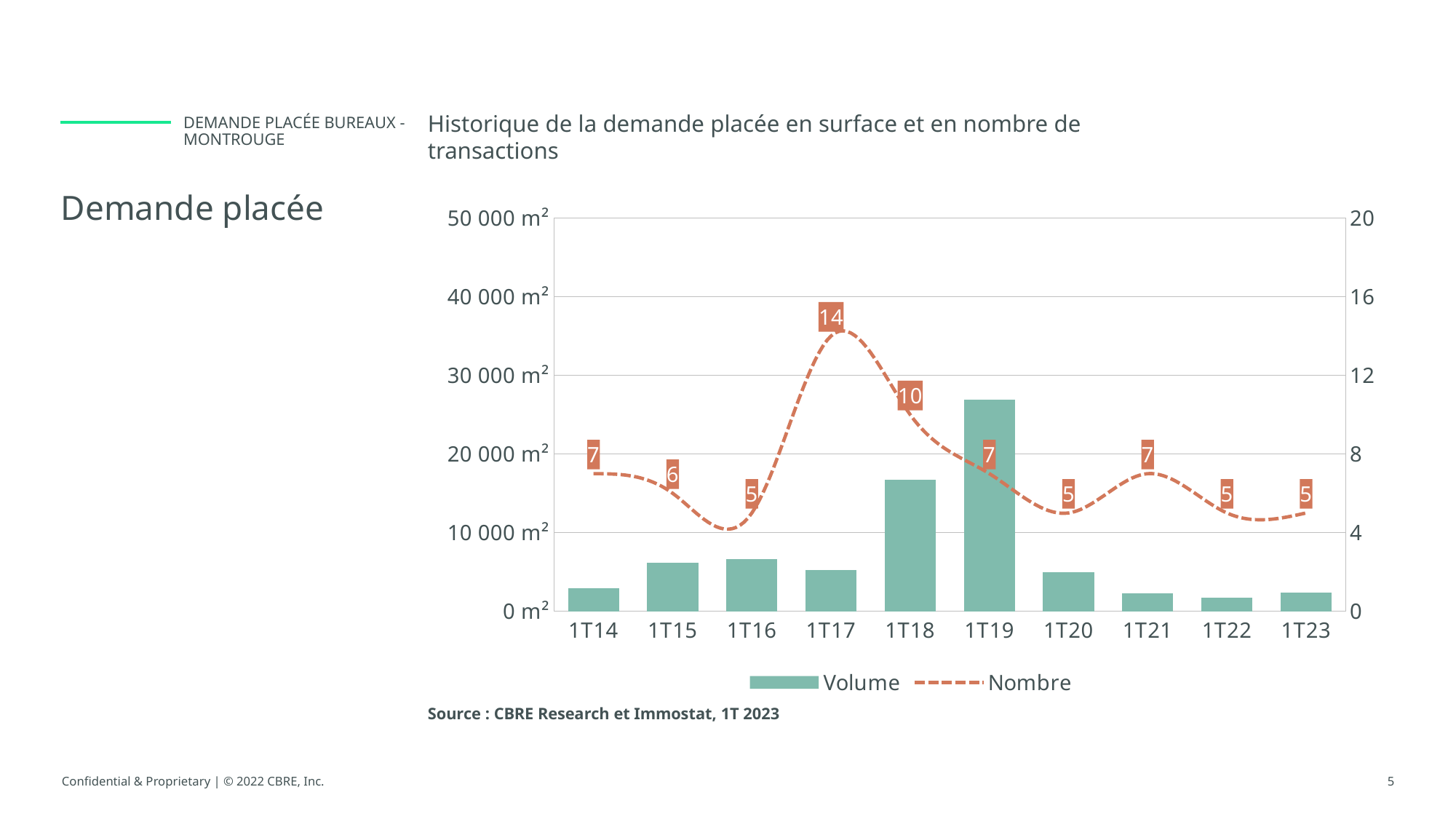
In which period is Nombre highest? 1T17 How many periods are shown on the x axis? 10 How many series does the legend list? 2 What is the value of Nombre for 1T17? 14 What is the value of Nombre for 1T23? 5 Is the Volume for 1T19 greater or less than 20 000 m²? greater What is the value of Nombre for 1T18? 10 Which is larger, Volume in 1T18 or Volume in 1T19? 1T19 What is the difference between Nombre in 1T17 and Nombre in 1T18? 4 Is the Volume for 1T14 greater or less than 10 000 m²? less In which period is Volume highest? 1T19 Does Nombre rise or fall from 1T17 to 1T20? fall